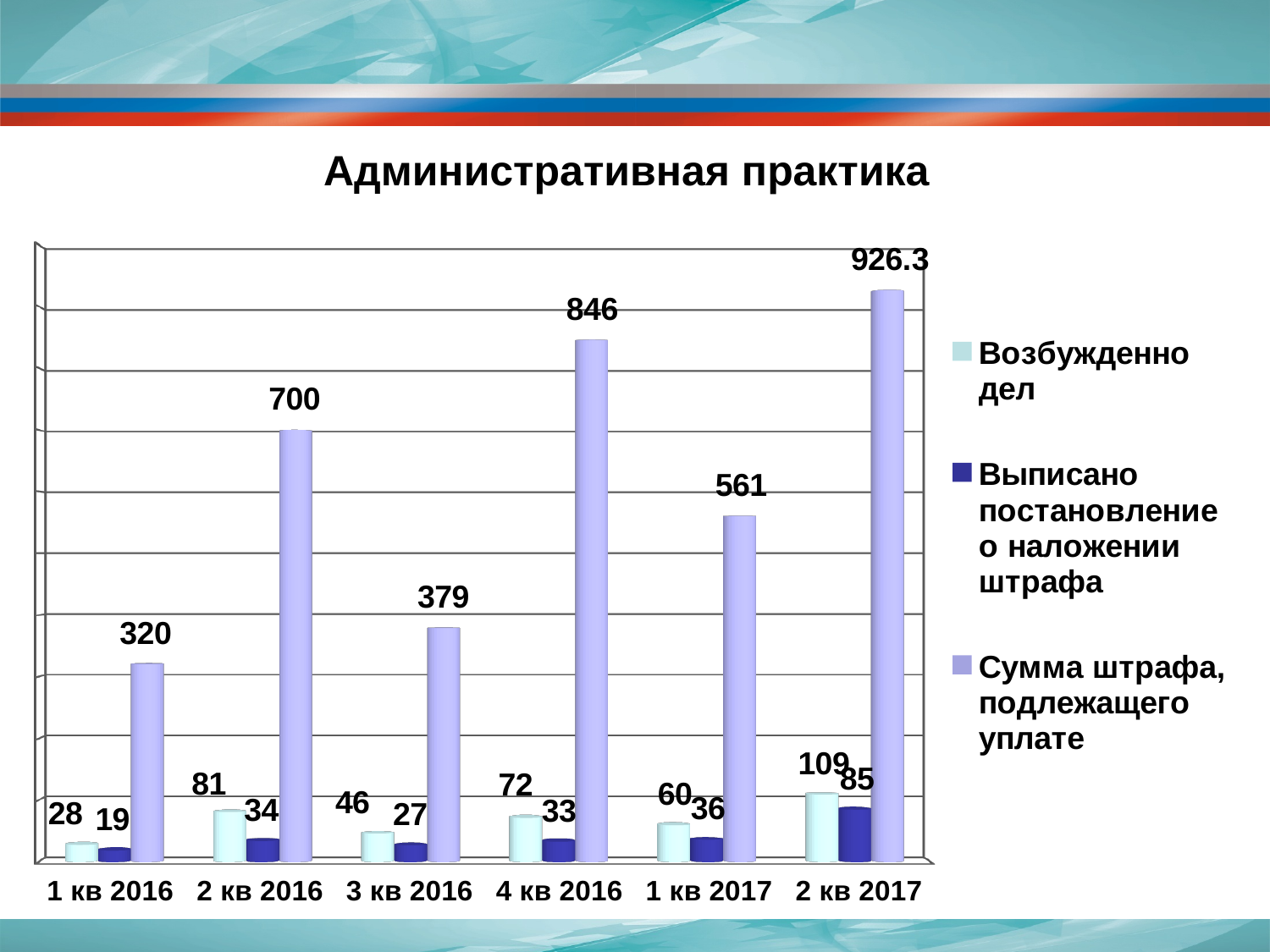
What is the difference between Возбужденно дел and Выписано постановление о наложении штрафа for 2 кв 2017? 24 Which is larger: Сумма штрафа, подлежащего уплате for 2 кв 2016 or for 1 кв 2017? 2 кв 2016 What is the value of Сумма штрафа, подлежащего уплате for 2 кв 2017? 926.3 What is the value of Возбужденно дел for 2 кв 2016? 81 What is the value of Выписано постановление о наложении штрафа for 1 кв 2017? 36 How many quarters are shown on the x axis? 6 How many series does the legend list? 3 Which quarter has the highest value for Сумма штрафа, подлежащего уплате? 2 кв 2017 What is the difference between Сумма штрафа, подлежащего уплате for 4 кв 2016 and 3 кв 2016? 467 Which quarter has the lowest value for Возбужденно дел? 1 кв 2016 What kind of chart is shown on the slide? Bar chart What is the title of the chart? Административная практика